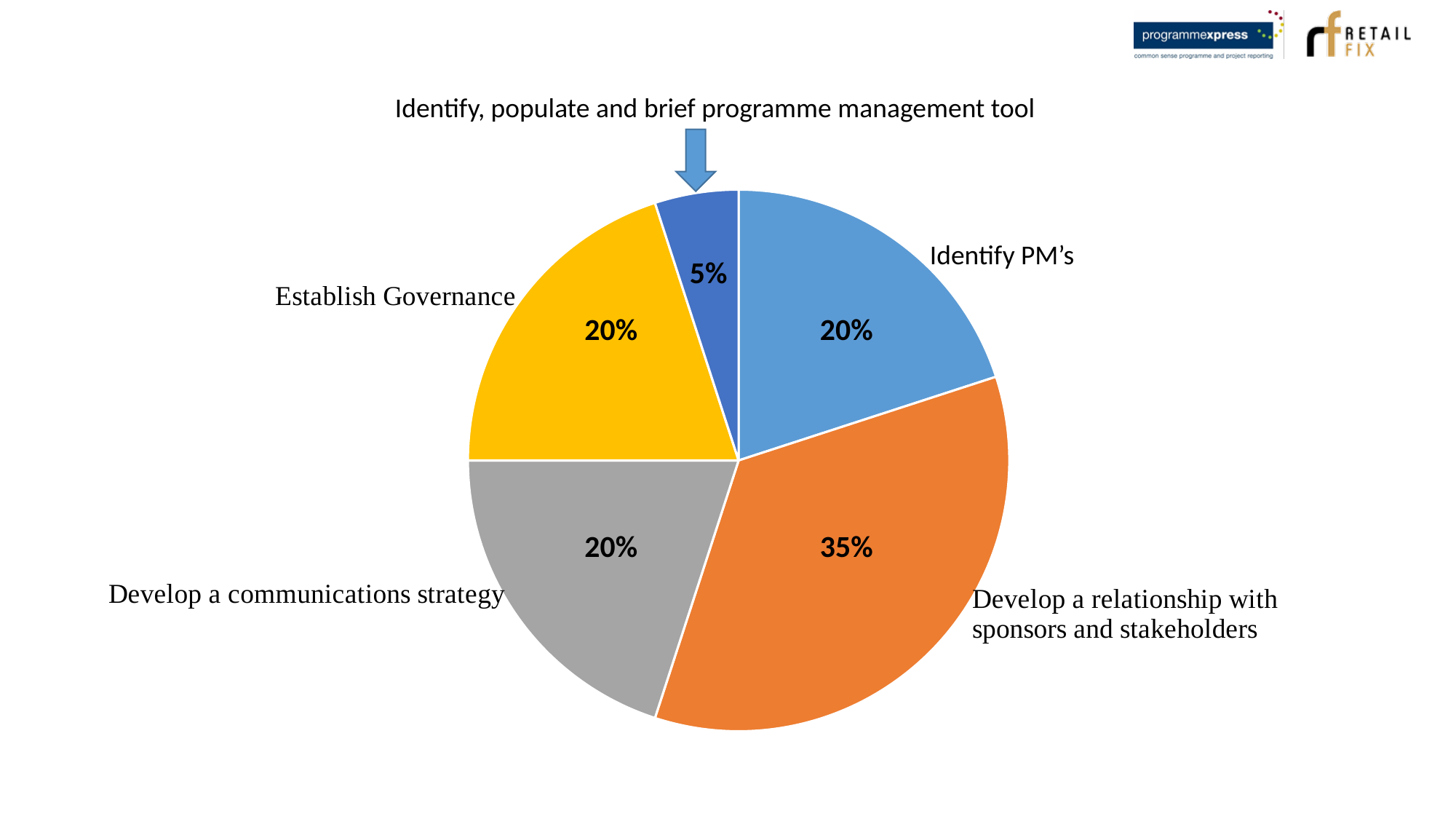
Which slice of the pie is the largest? Develop a relationship with sponsors and stakeholders What is the difference between the share for 'Develop a relationship with sponsors and stakeholders' and the share for 'Develop a communications strategy'? 15% What share of the pie does 'Establish Governance' have? 20% How many slices does the pie chart have? 5 What colour is the slice for 'Develop a communications strategy'? Grey What colour is the slice for 'Establish Governance'? Yellow What share of the pie does 'Develop a relationship with sponsors and stakeholders' have? 35% What share of the pie does 'Identify PM's' have? 20% What share of the pie does 'Identify, populate and brief programme management tool' have? 5% Which slice of the pie is the smallest? Identify, populate and brief programme management tool What kind of chart is shown on the slide? Pie chart Which is larger: the share for 'Establish Governance' or the share for 'Identify, populate and brief programme management tool'? Establish Governance